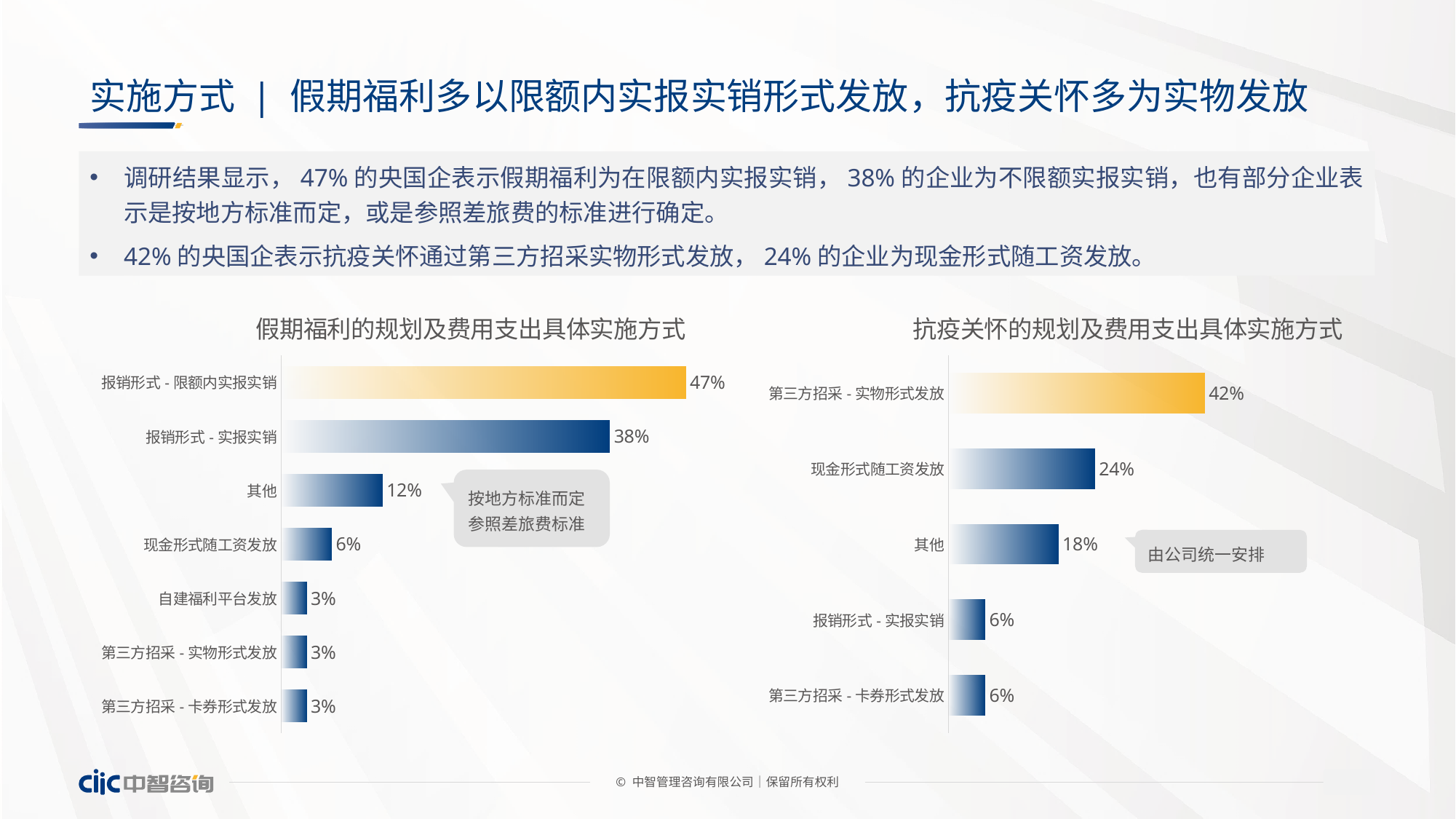
In the right chart (抗疫关怀的规划及费用支出具体实施方式), how many categories are shown? 5 In the left chart (假期福利的规划及费用支出具体实施方式), what is the value for 其他? 12% What kind of chart is the right chart (抗疫关怀的规划及费用支出具体实施方式)? Bar chart In the left chart (假期福利的规划及费用支出具体实施方式), how many categories are shown? 7 In the right chart (抗疫关怀的规划及费用支出具体实施方式), what is the difference between 第三方招采 - 实物形式发放 and 现金形式随工资发放? 18% In the right chart (抗疫关怀的规划及费用支出具体实施方式), what is the value for 第三方招采 - 实物形式发放? 42% In the right chart (抗疫关怀的规划及费用支出具体实施方式), what is the value for 其他? 18% In the left chart (假期福利的规划及费用支出具体实施方式), which is larger: 其他 or 现金形式随工资发放? 其他 In the left chart (假期福利的规划及费用支出具体实施方式), what is the difference between 报销形式 - 限额内实报实销 and 报销形式 - 实报实销? 9% What is the title of the left chart? 假期福利的规划及费用支出具体实施方式 In the left chart (假期福利的规划及费用支出具体实施方式), what is the value for 报销形式 - 限额内实报实销? 47% In the left chart (假期福利的规划及费用支出具体实施方式), which category has the highest value? 报销形式 - 限额内实报实销